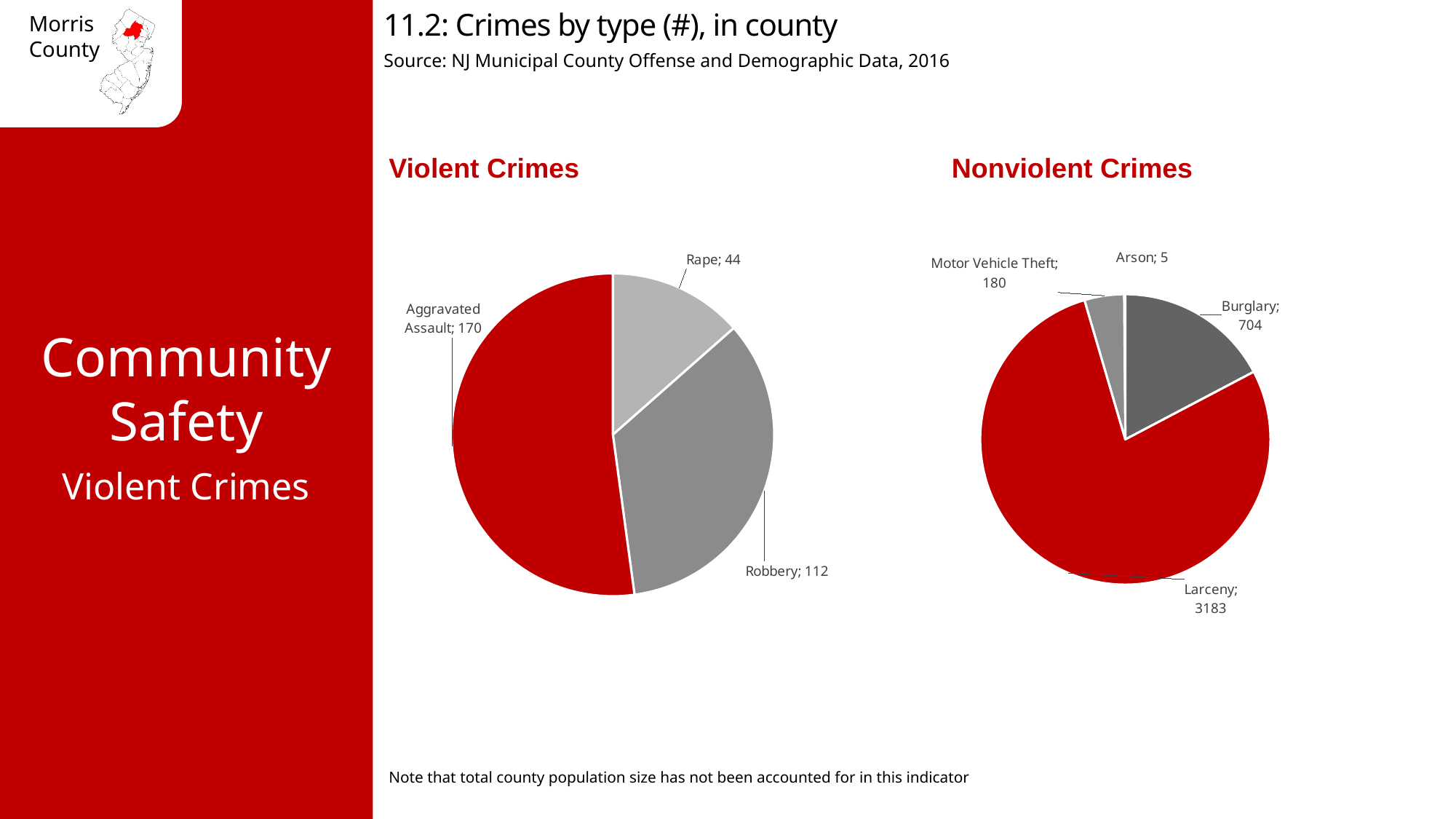
In the Nonviolent Crimes pie chart, what is the value for Larceny? 3183 In the Violent Crimes pie chart, how many aggravated assaults are shown? 170 What kind of chart is used for Violent Crimes? Pie chart In the Violent Crimes pie chart, which crime type has the largest slice? Aggravated Assault In the Nonviolent Crimes pie chart, what is the difference between Burglary and Motor Vehicle Theft? 524 In the Nonviolent Crimes pie chart, what is the value for Motor Vehicle Theft? 180 In the Nonviolent Crimes pie chart, which is larger, Burglary or Motor Vehicle Theft? Burglary In the Violent Crimes pie chart, what is the value for Robbery? 112 How many crime types are shown in the Nonviolent Crimes pie chart? 4 In the Violent Crimes pie chart, what is the difference between Aggravated Assault and Robbery? 58 What is the total of all values in the Violent Crimes pie chart? 326 In the Nonviolent Crimes pie chart, which crime type has the smallest value? Arson